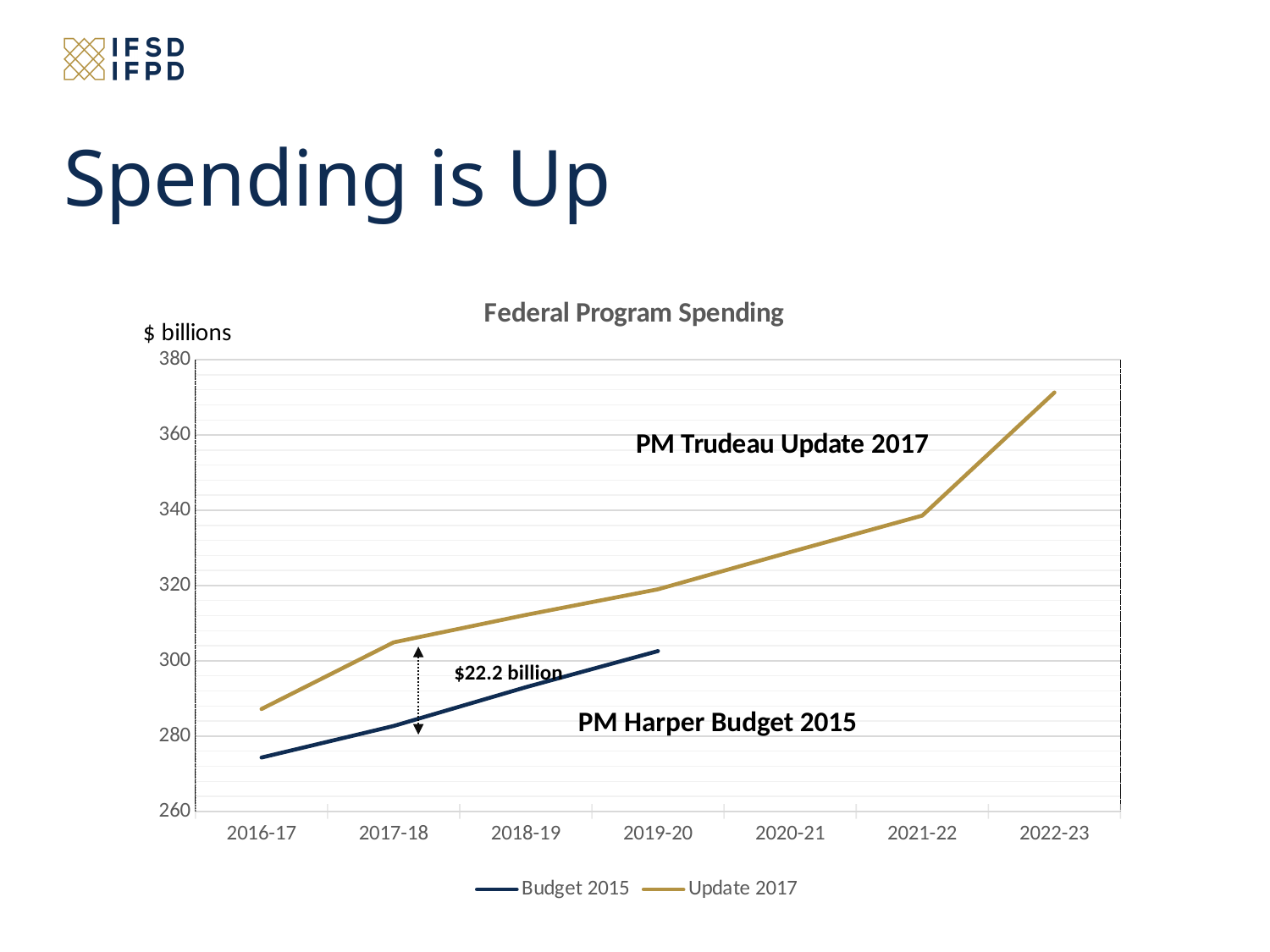
Is the Update 2017 value for 2022-23 greater or less than 360? greater Is the Update 2017 value for 2016-17 greater or less than 280? greater In which fiscal year is the Budget 2015 series at its lowest value? 2016-17 Is the Budget 2015 value for 2016-17 greater or less than 280? less In 2017-18, which series has the higher value, Budget 2015 or Update 2017? Update 2017 Does the Budget 2015 line rise or fall from 2016-17 to 2019-20? rise What gap between the two lines is annotated on the chart? $22.2 billion In which fiscal year does the Update 2017 series reach its highest value? 2022-23 How many series does the legend list? 2 What kind of chart is shown on the slide? line chart Does the Update 2017 line rise or fall from 2016-17 to 2022-23? rise How many fiscal years are shown on the x axis? 7